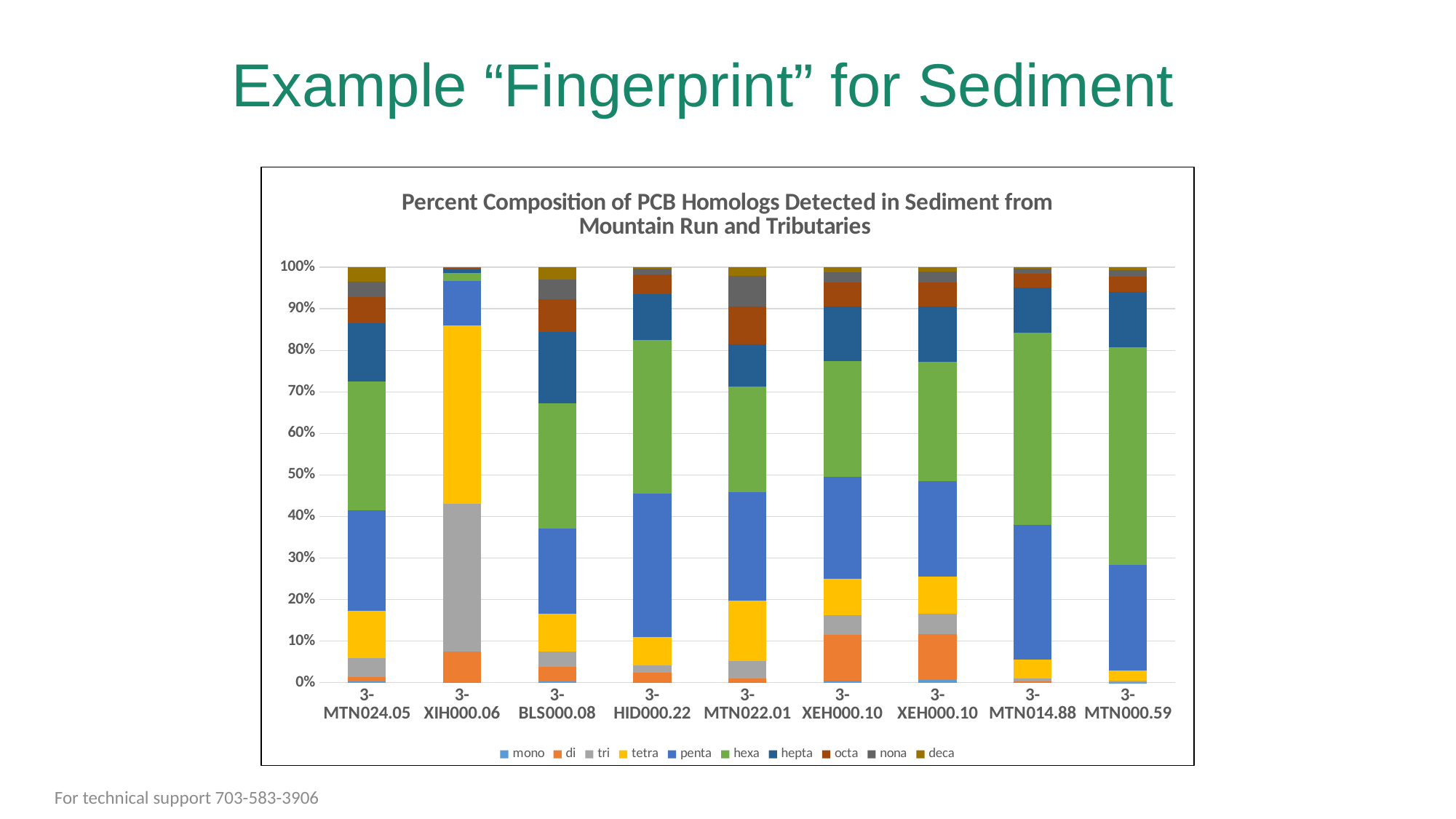
What is the title of the chart? Percent Composition of PCB Homologs Detected in Sediment from Mountain Run and Tributaries Is the tetra segment for 3-XIH000.06 greater or less than 30%? greater Which legend entry is shown in yellow? tetra Which site has the larger tetra segment, 3-MTN024.05 or 3-MTN000.59? 3-MTN024.05 How many homolog series does the legend list? 10 Which site has the largest tetra segment? 3-XIH000.06 Which site has the largest tri segment? 3-XIH000.06 What kind of chart is shown on the slide? Stacked bar chart Which site has the largest hexa segment? 3-MTN000.59 What does each stacked bar total? 100% How many sediment sampling sites (bars) are shown in the chart? 9 Which site has the smallest hexa segment? 3-XIH000.06